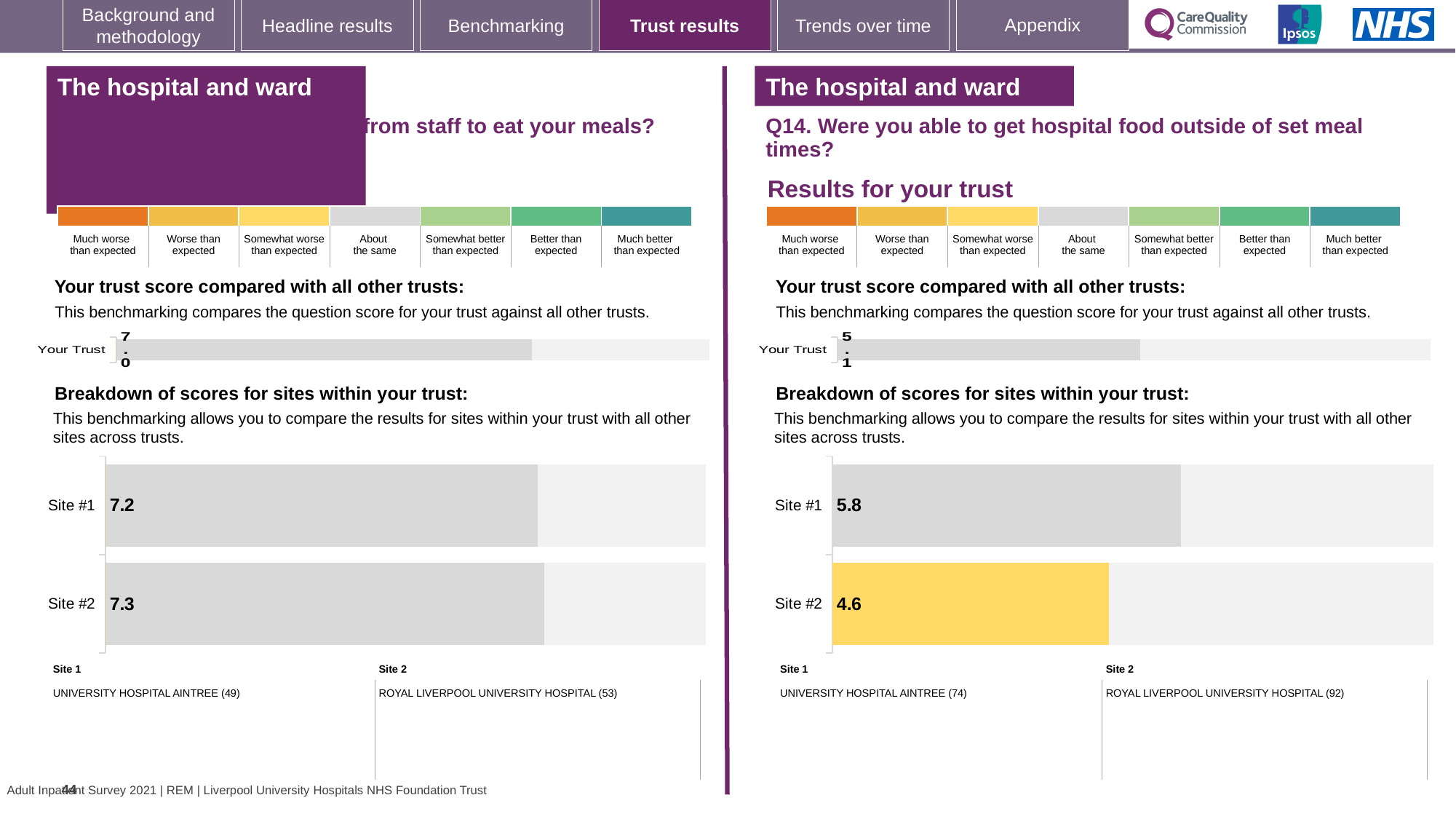
How many sites are shown in the site breakdown chart on the right-hand side for Q14? 2 On the right-hand chart for Q14 (hospital food outside of set meal times), what is the score for Site #1? 5.8 What type of chart is used for the breakdown of scores for sites on the right-hand side for Q14? bar chart On the left-hand chart (question about help from staff to eat your meals), what is the score for Site #2? 7.3 On the right-hand chart for Q14, what is the score for Site #2? 4.6 On the left-hand chart (question about help from staff to eat your meals), what is the score for Site #1? 7.2 On the right-hand chart for Q14, what is the 'Your Trust' score? 5.1 On the left-hand chart (question about help from staff to eat your meals), what is the difference between the Site #2 and Site #1 scores? 0.1 On the left-hand chart (question about help from staff to eat your meals), what is the 'Your Trust' score? 7.0 On the right-hand chart for Q14, is the Site #2 score larger or smaller than the 'Your Trust' score? smaller On the right-hand chart for Q14, what is the difference between the Site #1 and Site #2 scores? 1.2 On the right-hand chart for Q14, which site has the higher score? Site #1